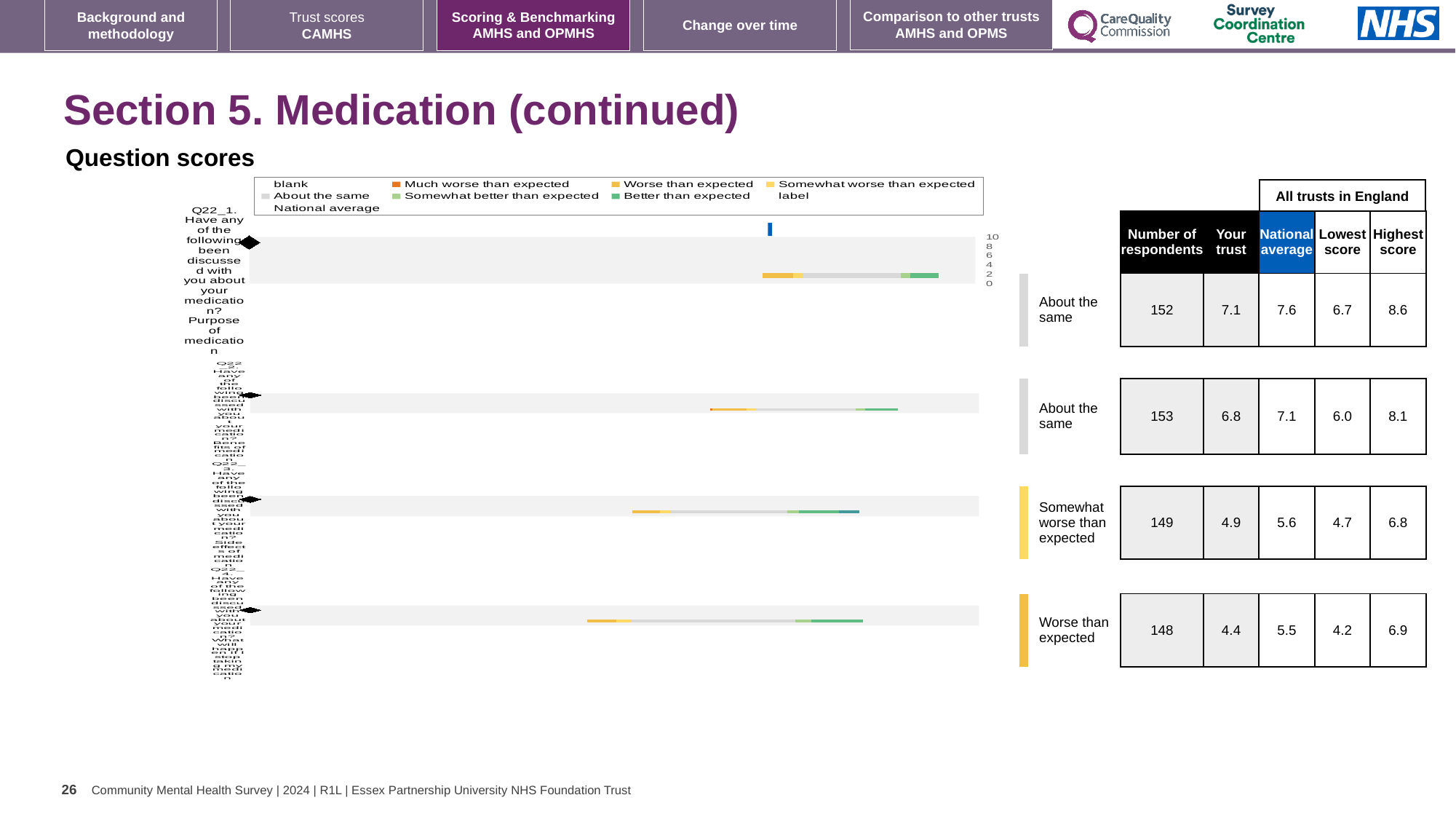
Which row in the table has the highest 'Your trust' score? the first row, Q22_1 (7.1) What kind of chart is shown on the slide? bar chart How many entries does the chart legend list? 9 What is the heading above the 'National average', 'Lowest score' and 'Highest score' columns in the table? All trusts in England How many question bars are plotted in the chart? 4 Which row in the table has the lowest 'Your trust' score? Worse than expected (4.4) What colour does the legend use for 'Much worse than expected'? orange In the row rated 'Worse than expected', what is the difference between the national average and the 'Your trust' score? 1.1 In the table, how many respondents are listed for the row rated 'Worse than expected'? 148 In the table, what is the 'Your trust' score for the first row (Q22_1, purpose of medication)? 7.1 In the table, what is the highest score for the row rated 'Somewhat worse than expected'? 6.8 In the row rated 'Somewhat worse than expected', is the 'Your trust' score higher or lower than the national average? lower